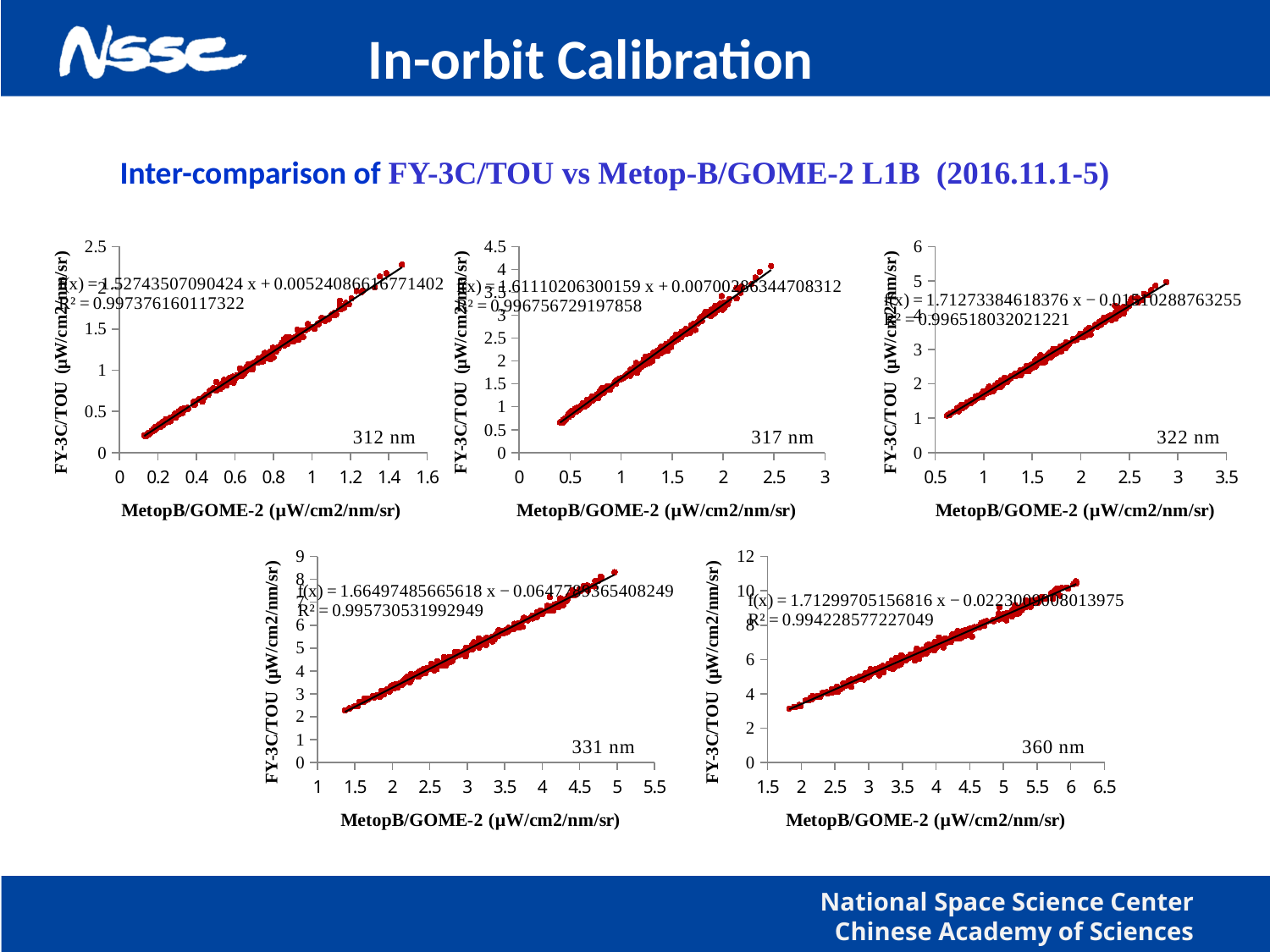
On the 360 nm chart, is the highest plotted FY-3C/TOU value greater or less than 8? greater On the 360 nm chart, do the plotted FY-3C/TOU values rise or fall as the MetopB/GOME-2 values increase? rise On the 312 nm chart, is the highest plotted FY-3C/TOU value greater or less than 2? greater What kind of chart is the 312 nm chart? scatter chart What is the R² value printed on the 312 nm chart? 0.997376160117322 What is the x-axis title of the 317 nm chart? MetopB/GOME-2 (μW/cm2/nm/sr) What is the R² value printed on the 360 nm chart? 0.994228577227049 What is the maximum value shown on the y-axis of the 322 nm chart? 6 Which chart has the lowest printed R² value? 360 nm How many charts are shown on the slide? 5 What is the R² value printed on the 331 nm chart? 0.995730531992949 Which chart has the highest printed R² value? 312 nm